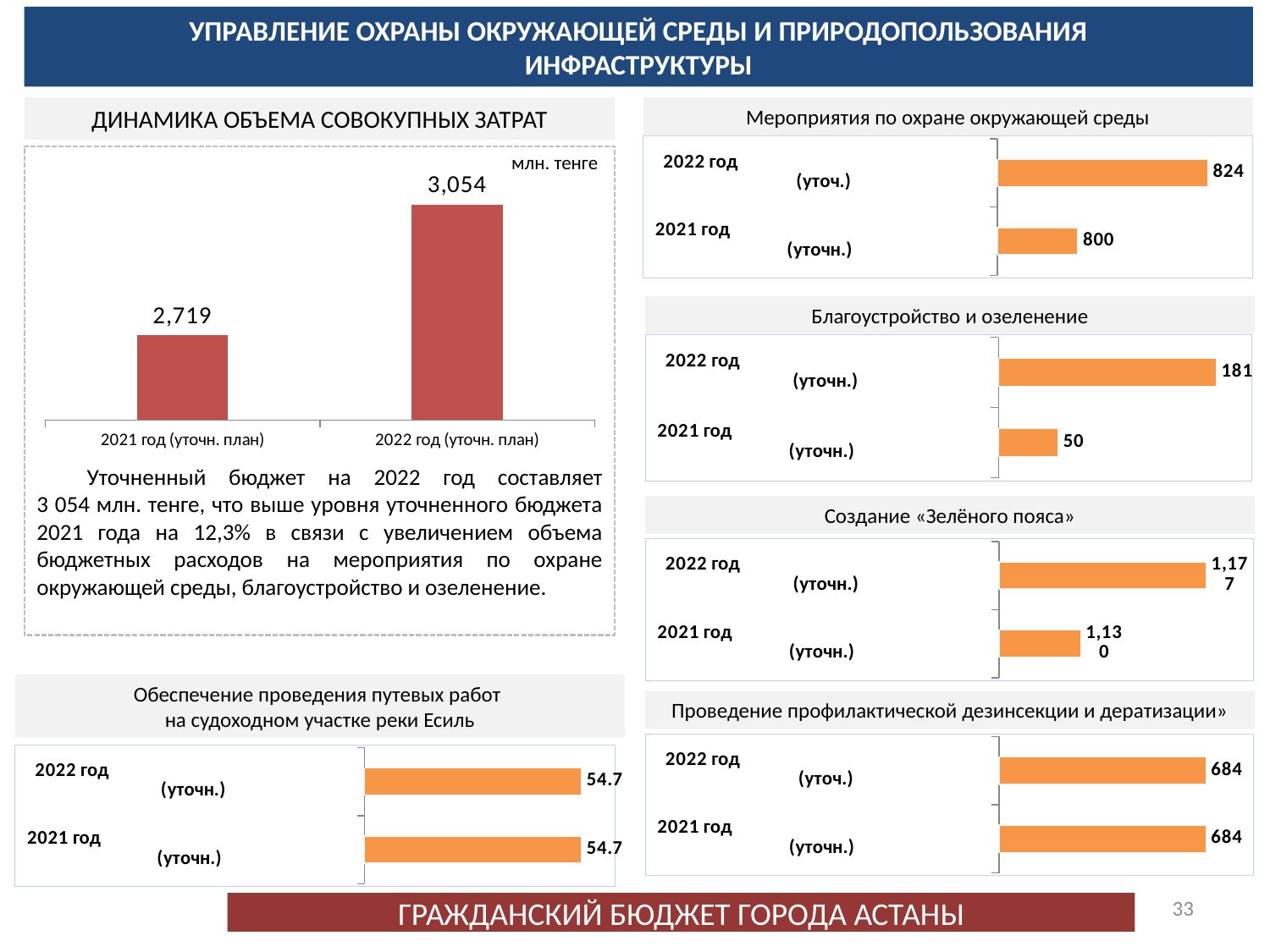
In the chart 'ДИНАМИКА ОБЪЕМА СОВОКУПНЫХ ЗАТРАТ', what is the difference between the 2022 and 2021 values? 335 In the chart 'Обеспечение проведения путевых работ на судоходном участке реки Есиль', how many bars are shown? 2 In the chart 'ДИНАМИКА ОБЪЕМА СОВОКУПНЫХ ЗАТРАТ', what unit is shown for the values? млн. тенге In the chart 'Благоустройство и озеленение', which year has the higher value? 2022 год (уточн.) In the chart 'Создание «Зелёного пояса»', what is the value for 2022 год (уточн.)? 1,177 In the chart 'ДИНАМИКА ОБЪЕМА СОВОКУПНЫХ ЗАТРАТ', what is the value for 2022 год (уточн. план)? 3,054 In the chart 'Мероприятия по охране окружающей среды', what is the difference between the 2022 and 2021 values? 24 In the chart 'Мероприятия по охране окружающей среды', what is the value for 2022 год (уточн.)? 824 In the chart 'Проведение профилактической дезинсекции и дератизации', what is the value for 2021 год (уточн.)? 684 In the chart 'Благоустройство и озеленение', what is the value for 2021 год (уточн.)? 50 What type of chart is 'ДИНАМИКА ОБЪЕМА СОВОКУПНЫХ ЗАТРАТ'? Bar chart In the chart 'ДИНАМИКА ОБЪЕМА СОВОКУПНЫХ ЗАТРАТ', what is the value for 2021 год (уточн. план)? 2,719